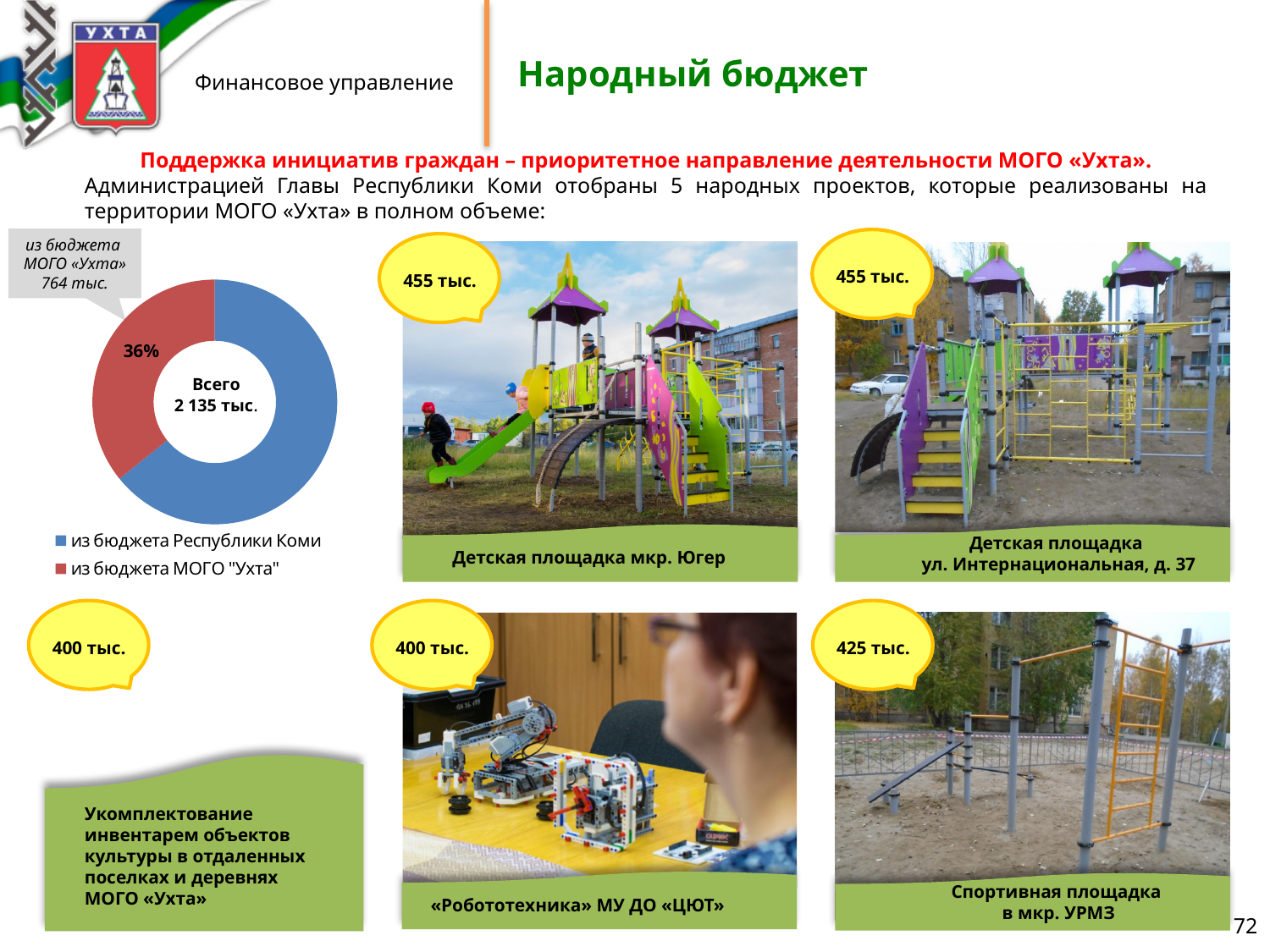
How many slices does the doughnut chart have? 2 How many entries does the legend of the doughnut chart list? 2 What share of the total does the slice "из бюджета МОГО "Ухта"" represent in the doughnut chart? 36% What total amount is shown in the centre of the doughnut chart? 2 135 тыс. Which source accounts for the larger slice of the doughnut chart? из бюджета Республики Коми What colour is the slice for "из бюджета Республики Коми" in the doughnut chart? blue Is the share of "из бюджета МОГО "Ухта"" greater or less than 50%? less What kind of chart is shown on the left of the slide? doughnut (pie) chart Is the slice for "из бюджета Республики Коми" larger or smaller than the slice for "из бюджета МОГО "Ухта""? larger What colour is the slice for "из бюджета МОГО "Ухта"" in the doughnut chart? red According to the callout next to the doughnut chart, how much comes from the budget of МОГО «Ухта»? 764 тыс. Which source accounts for the smaller slice of the doughnut chart? из бюджета МОГО "Ухта"